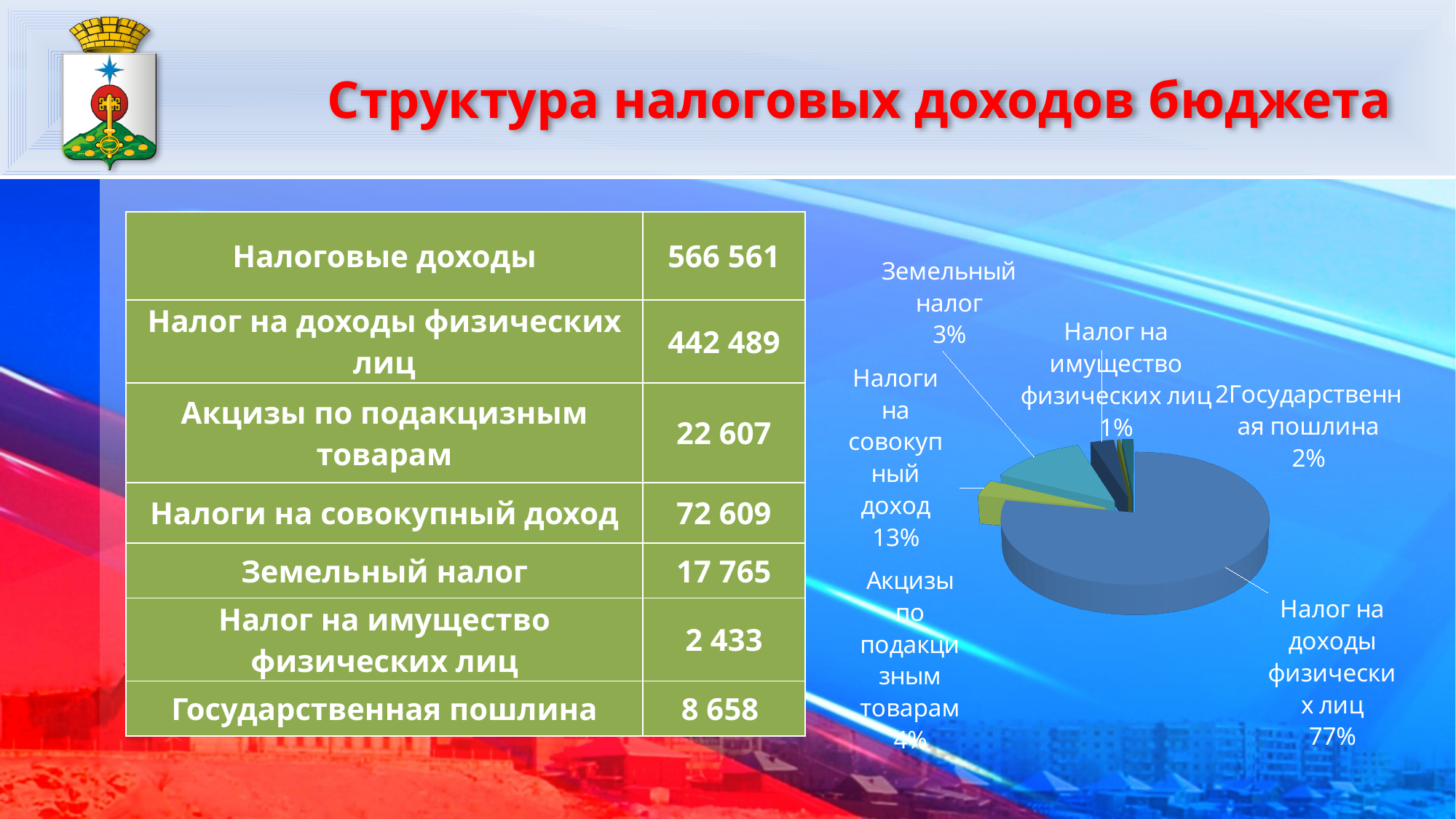
Which slice of the pie chart is the smallest? Налог на имущество физических лиц What share of the pie does "Государственная пошлина" have? 2% Which is larger in the pie chart: "Налоги на совокупный доход" or "Акцизы по подакцизным товарам"? Налоги на совокупный доход What share of the pie does "Налог на имущество физических лиц" have? 1% Which slice of the pie chart is the largest? Налог на доходы физических лиц What share of the pie does "Налог на доходы физических лиц" have? 77% What kind of chart is shown on the slide? pie chart What is the difference in percentage points between "Налоги на совокупный доход" and "Земельный налог" in the pie chart? 10% How many slices does the pie chart have? 6